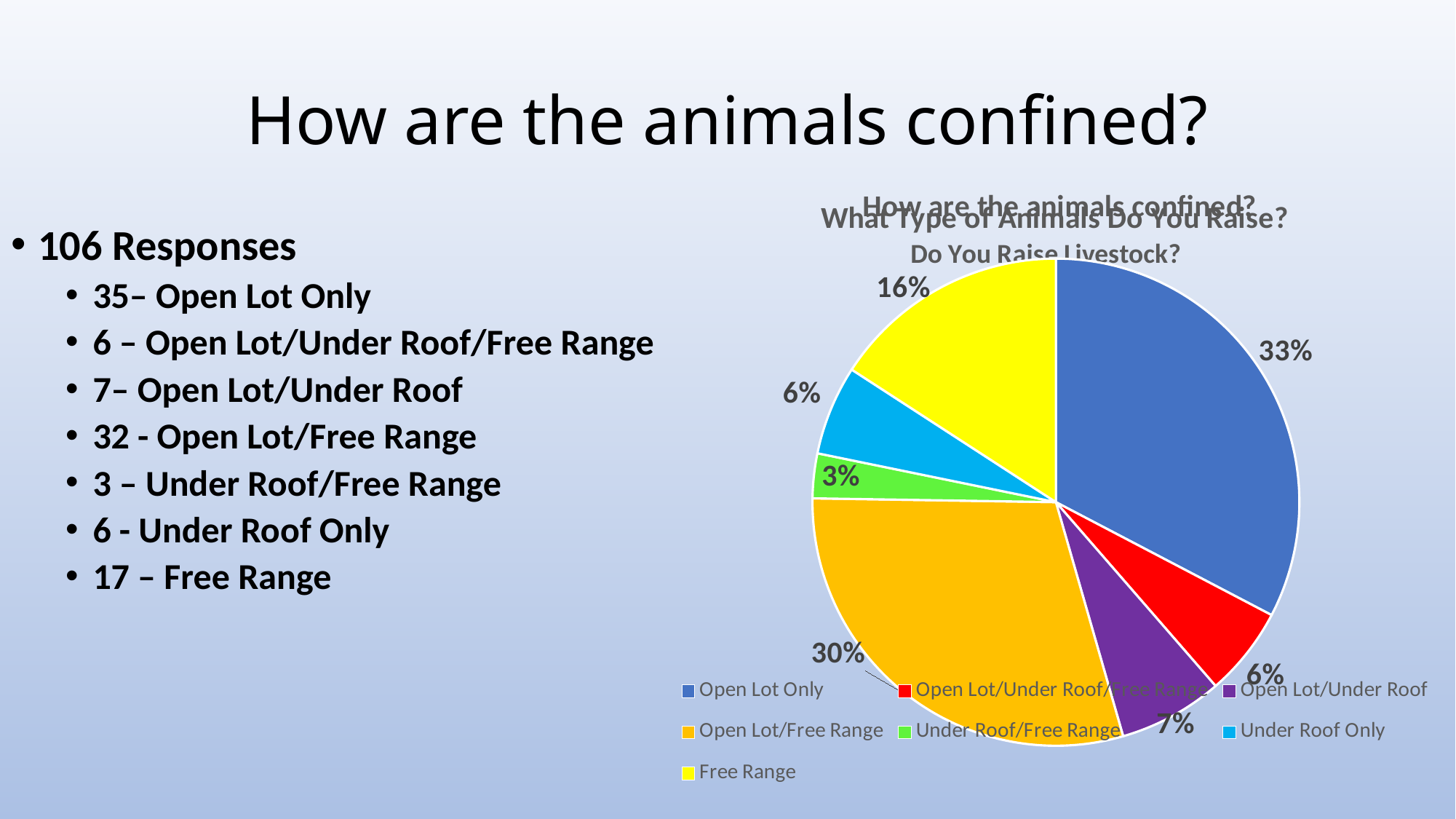
Which category has the largest slice of the pie? Open Lot Only What share of the pie does Free Range represent? 16% What colour is the Open Lot/Free Range slice? orange What share of the pie does Open Lot/Under Roof represent? 7% What kind of chart is shown on the slide? pie chart How many percentage points larger is the Open Lot Only slice than the Open Lot/Free Range slice? 3 How many categories does the legend list? 7 What share of the pie does Open Lot Only represent? 33% Which slice is larger, Free Range or Open Lot/Under Roof? Free Range Which category has the smallest slice of the pie? Under Roof/Free Range What share of the pie does Open Lot/Free Range represent? 30% What share of the pie does Under Roof/Free Range represent? 3%